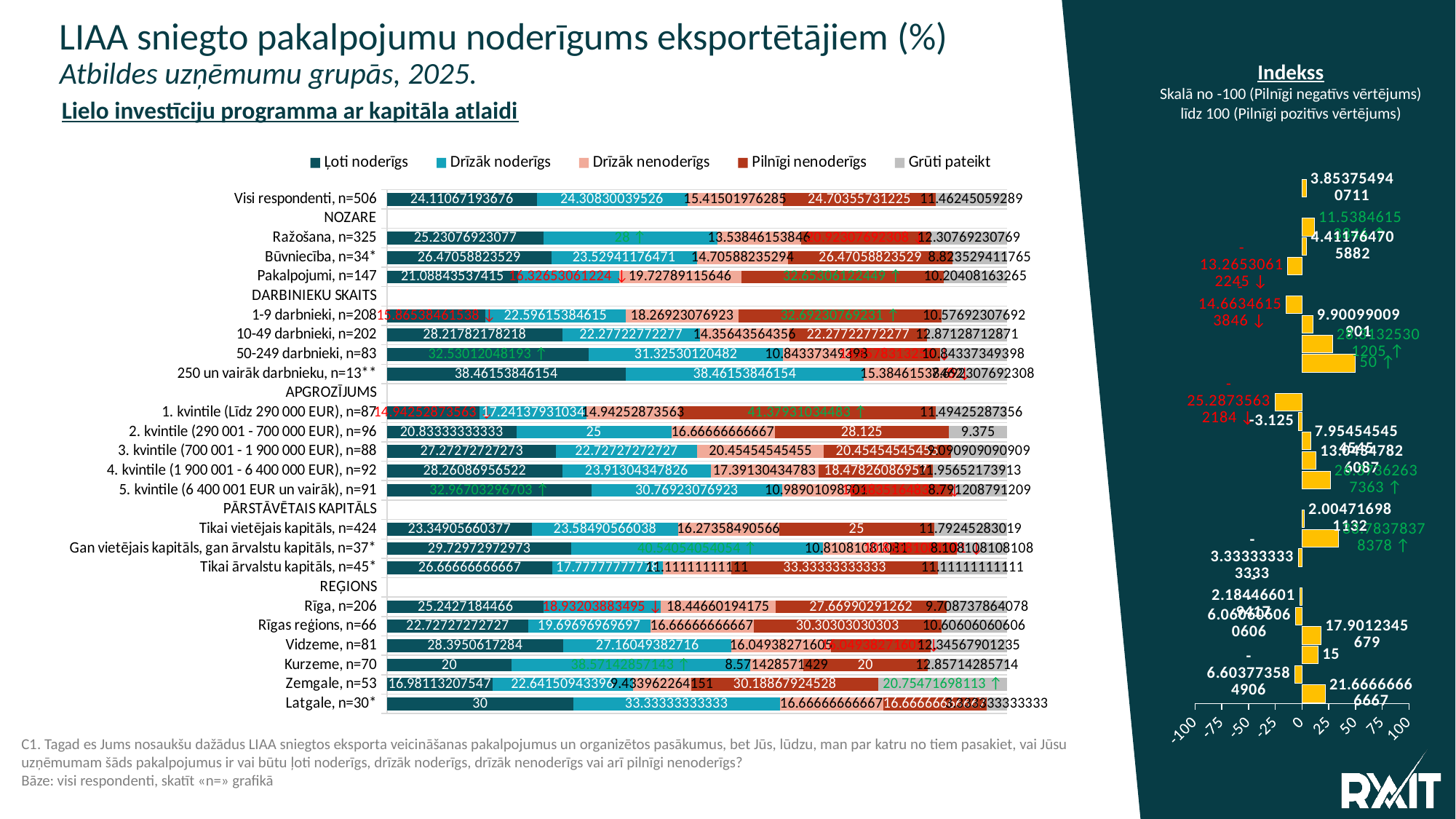
In the Indekss chart on the right, what is the index value for 2. kvintile (290 001 - 700 000 EUR)? -3.125 What kind of chart is the main chart on the left of the slide? Stacked bar chart In the main stacked bar chart, what is the 'Pilnīgi nenoderīgs' value for Tikai vietējais kapitāls, n=424? 25 In the main stacked bar chart, what is the 'Ļoti noderīgs' value for Latgale, n=30*? 30 In the main stacked bar chart, what is the 'Grūti pateikt' value for 2. kvintile (290 001 - 700 000 EUR), n=96? 9.375 In the main stacked bar chart, what is the 'Ļoti noderīgs' value for Visi respondenti, n=506? 24.11067193676 In the main stacked bar chart, what is the 'Pilnīgi nenoderīgs' value for 2. kvintile (290 001 - 700 000 EUR), n=96? 28.125 In the main stacked bar chart, which is larger for Kurzeme, n=70: the 'Ļoti noderīgs' value or the 'Drīzāk noderīgs' value? Drīzāk noderīgs In the Indekss chart on the right, what is the index value for Kurzeme? 15 In the main stacked bar chart, what is the difference between the 'Drīzāk noderīgs' value (25) and the 'Grūti pateikt' value (9.375) for 2. kvintile (290 001 - 700 000 EUR), n=96? 15.625 In the main stacked bar chart, what is the 'Drīzāk noderīgs' value for Kurzeme, n=70? 38.57142857143 How many series does the legend of the main stacked bar chart list? 5